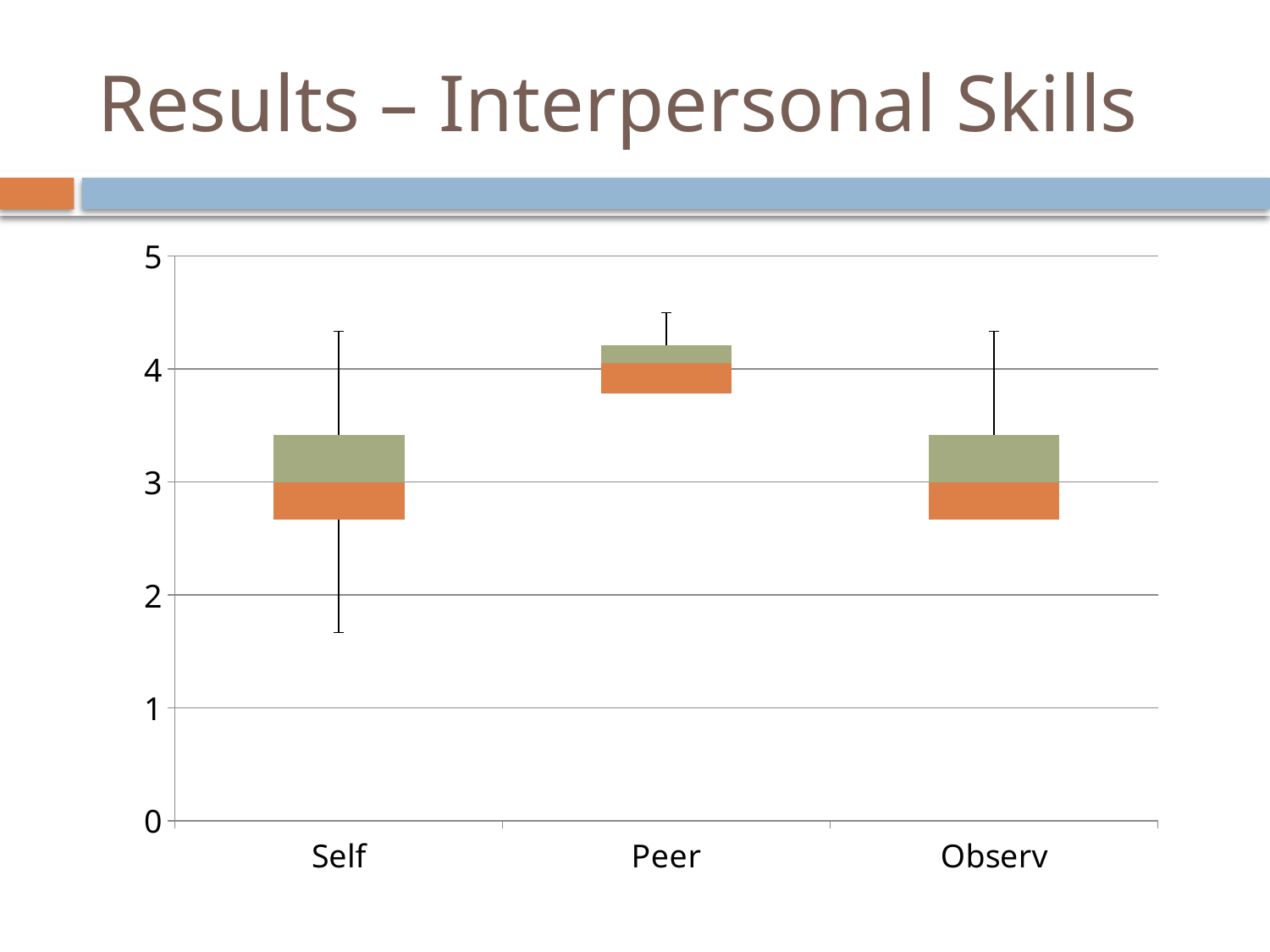
Which category has the highest box on the chart? Peer Is the bottom of the box for Self greater or less than 3? less What kind of chart is shown on the slide? box plot What is the title of the slide containing the chart? Results – Interpersonal Skills Is the top of the upper whisker for Peer greater or less than 4? greater Is the top of the upper whisker for Observ greater or less than 4? greater Which is higher on the chart, the box for Peer or the box for Observ? Peer How many categories are shown on the x axis of the chart? 3 What is the maximum value shown on the y axis of the chart? 5